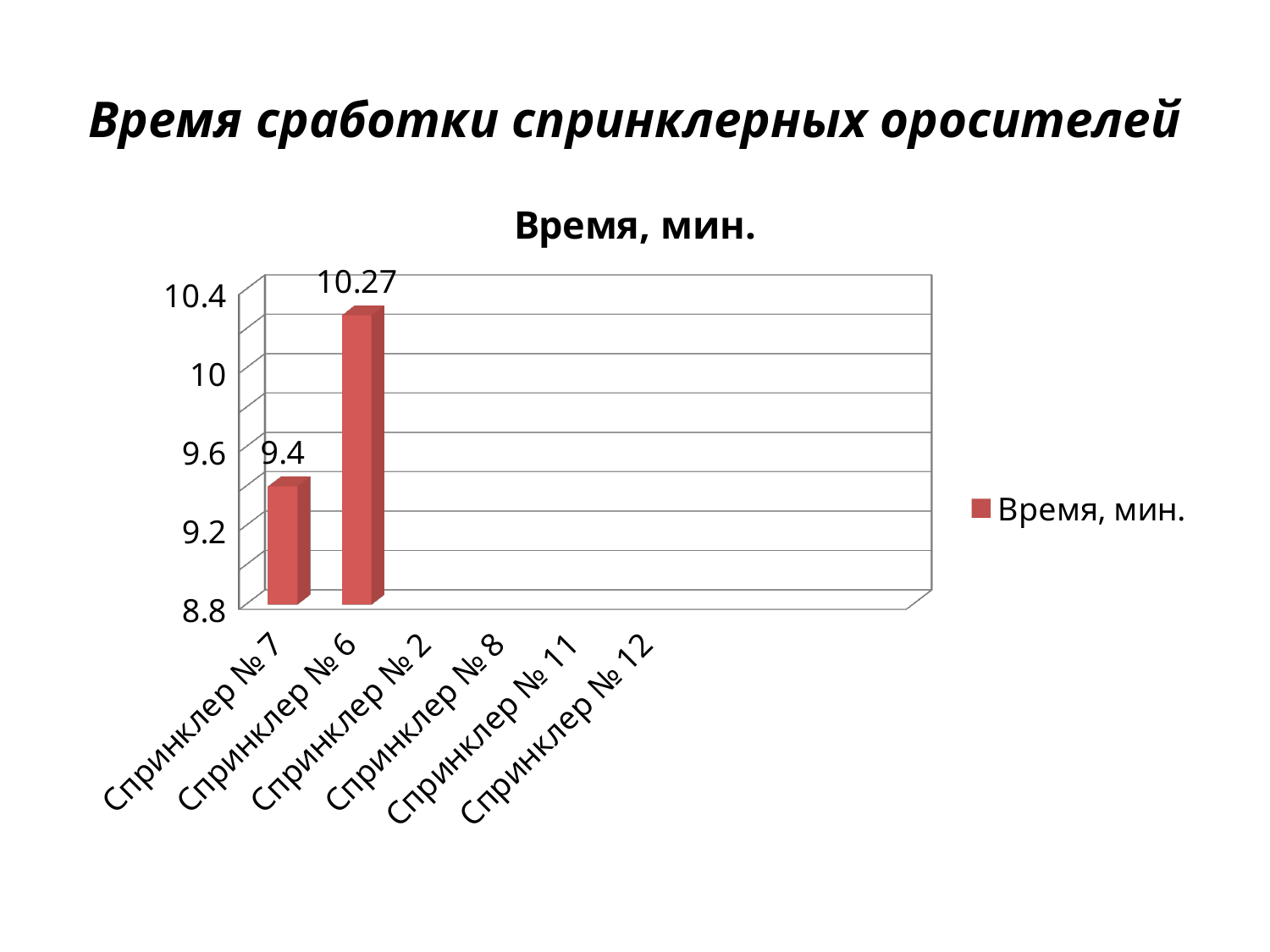
What is the value for Спринклер № 6? 10.27 Is the value for Спринклер № 6 greater or less than 10? greater Is the value for Спринклер № 7 greater or less than 9.6? less What is the title of the chart? Время, мин. Which is larger, the value for Спринклер № 6 or Спринклер № 7? Спринклер № 6 What kind of chart is shown? bar chart How many bars are actually plotted on the chart? 2 Which category has the highest plotted value? Спринклер № 6 How many categories are labelled on the x axis? 6 What is the value for Спринклер № 7? 9.4 How many series does the legend list? 1 What is the difference between the values for Спринклер № 6 and Спринклер № 7? 0.87